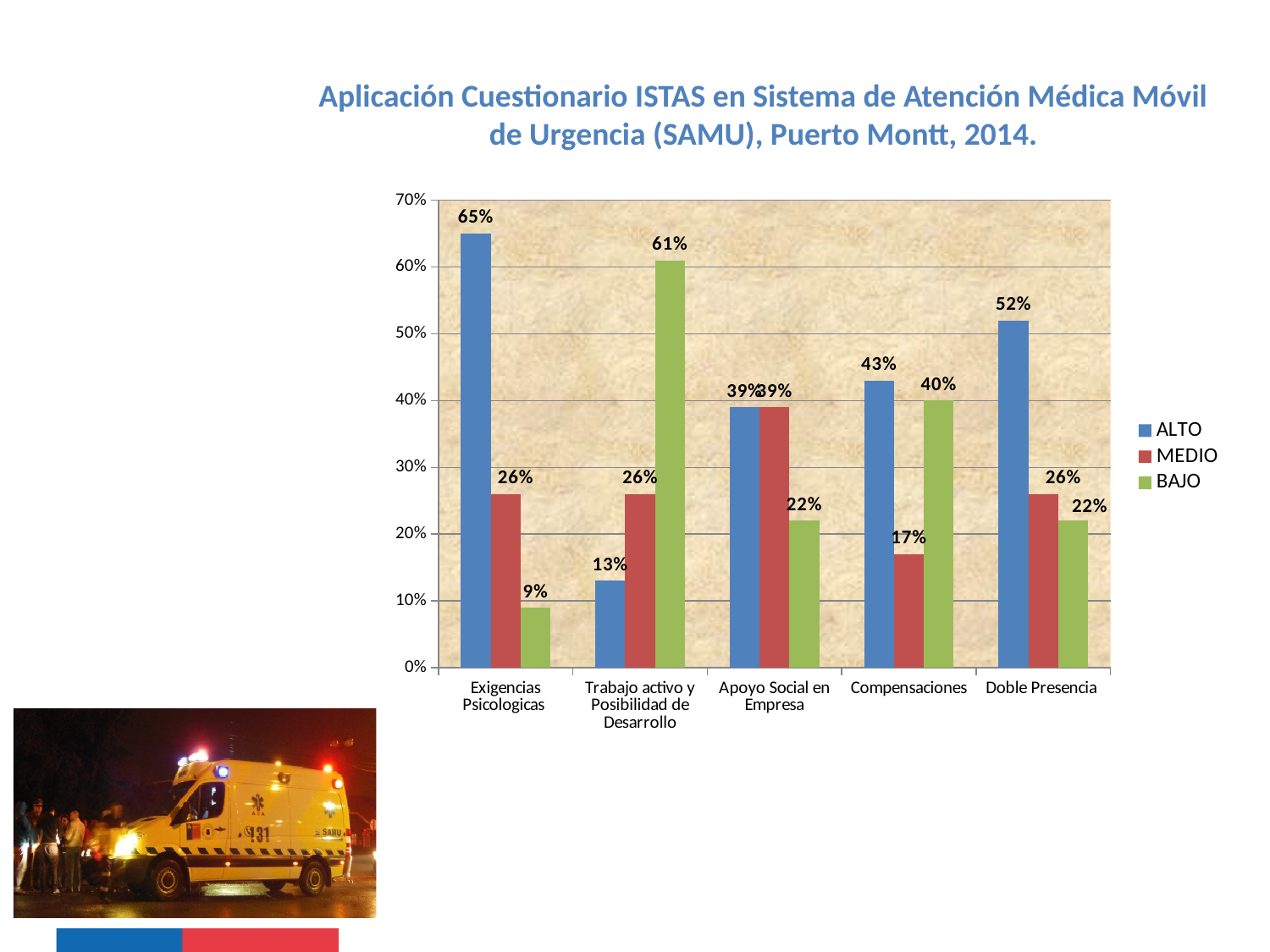
What is the MEDIO value for Compensaciones? 17% What is the difference between the ALTO and BAJO values for Doble Presencia? 30% What is the BAJO value for Trabajo activo y Posibilidad de Desarrollo? 61% What is the ALTO value for Trabajo activo y Posibilidad de Desarrollo? 13% Which colour represents the MEDIO series in the legend? Red Which is larger for Compensaciones, the ALTO value or the BAJO value? ALTO How many categories are shown on the x axis? 5 Which category has the highest ALTO value? Exigencias Psicologicas How many series does the legend list? 3 What is the ALTO value for Exigencias Psicologicas? 65% Which category has the lowest BAJO value? Exigencias Psicologicas What kind of chart is shown on the slide? Bar chart